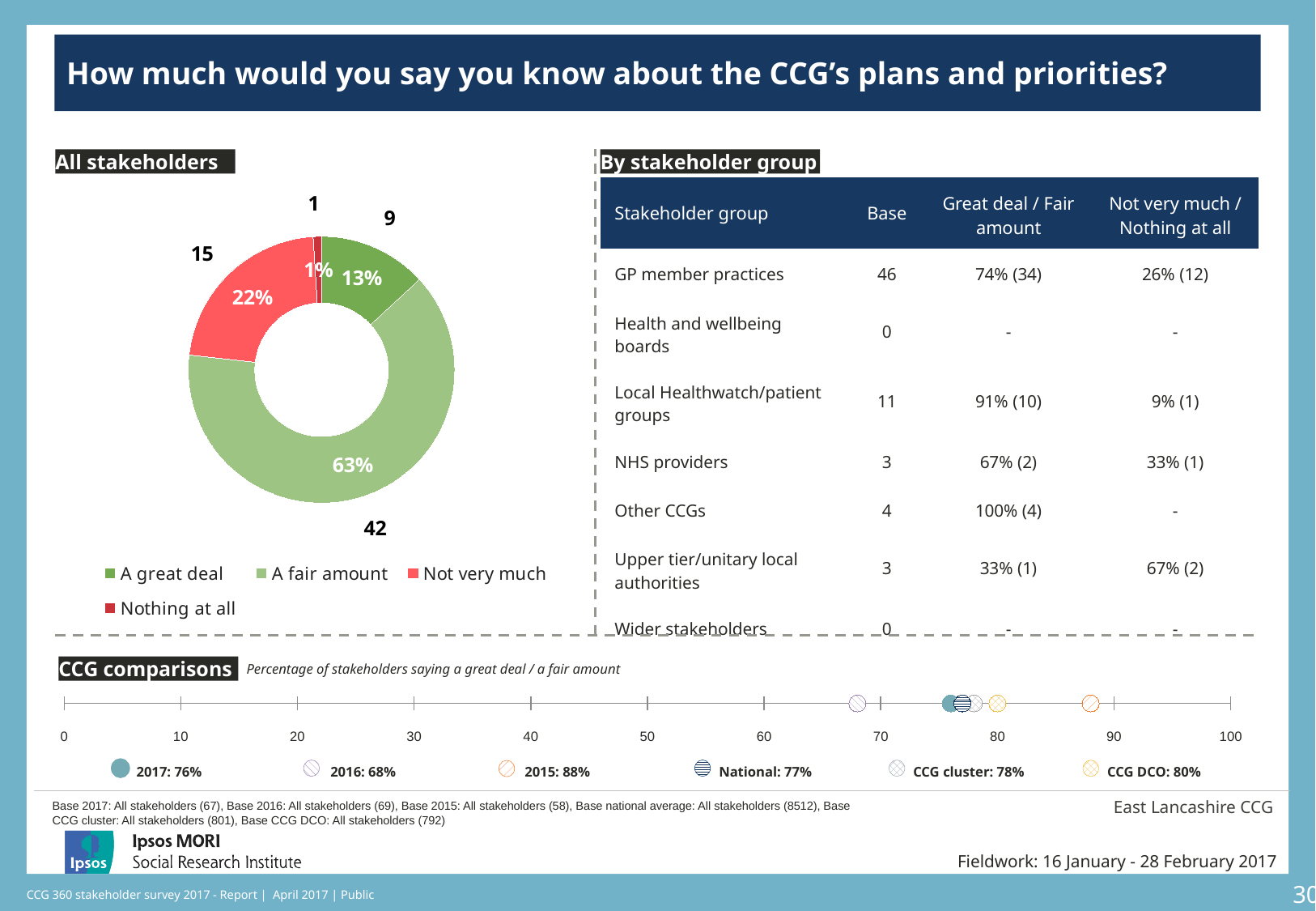
What type of chart is the 'All stakeholders' chart? Donut (pie) chart In the 'All stakeholders' chart, which response has the largest share? A fair amount In the 'All stakeholders' chart, which is larger: 'A great deal' or 'Not very much'? Not very much In the 'All stakeholders' chart, what percentage said 'A great deal'? 13% In the 'All stakeholders' chart, which response has the smallest share? Nothing at all In the 'All stakeholders' chart, what percentage of stakeholders said they know 'A fair amount'? 63% In the 'CCG comparisons' chart, what is the difference between the CCG DCO value and the 2017 value? 4 percentage points In the 'CCG comparisons' chart, what is the 2017 percentage of stakeholders saying a great deal / a fair amount? 76% In the 'All stakeholders' chart, what is the difference in percentage points between 'A fair amount' and 'Not very much'? 41 In the 'CCG comparisons' chart, which year has the highest percentage? 2015 How many response categories does the legend of the 'All stakeholders' chart list? 4 In the 'All stakeholders' chart, what percentage of stakeholders said 'Not very much'? 22%